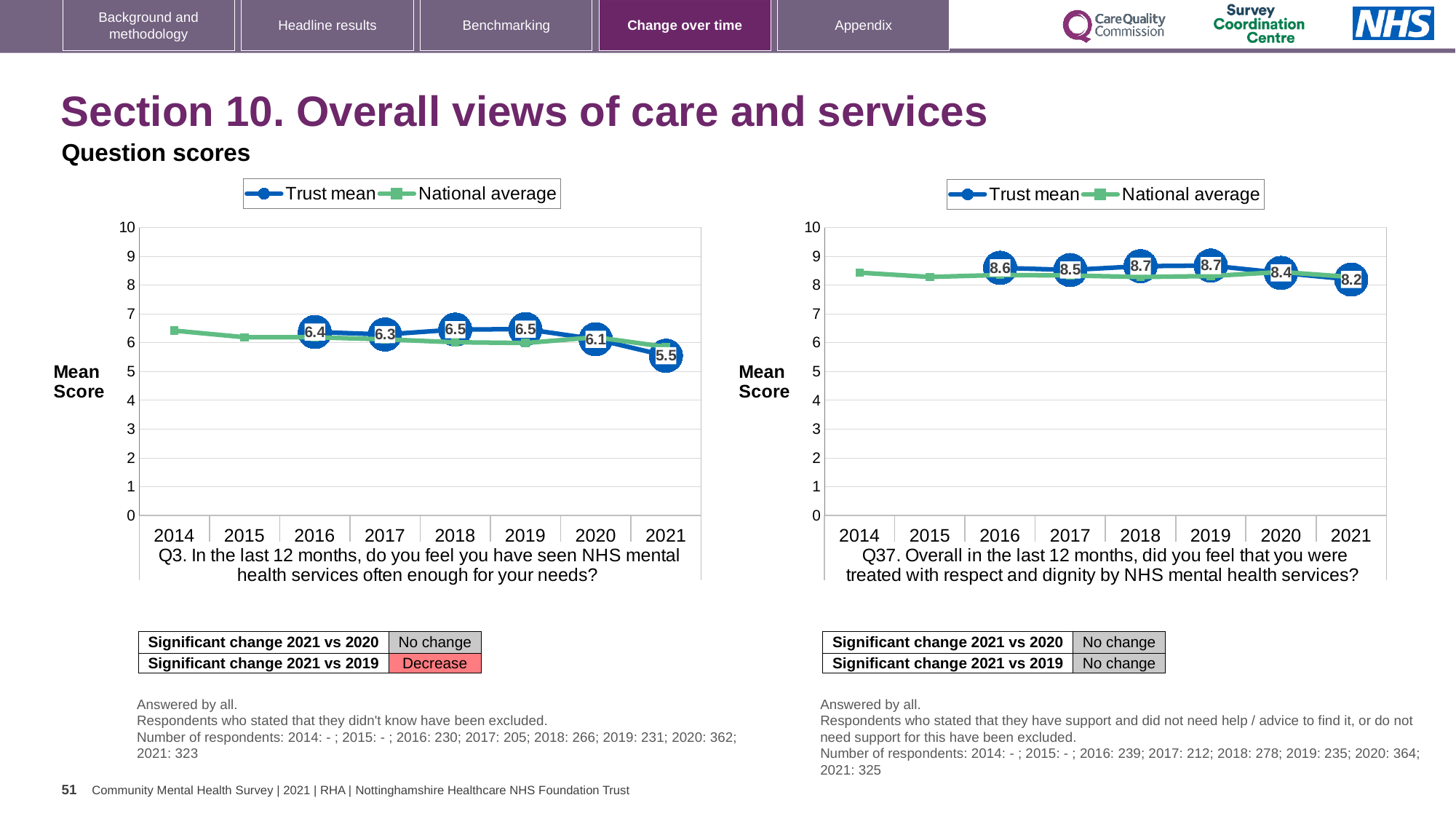
In the right chart (Q37), which year has the lowest Trust mean? 2021 In the left chart (Q3), which year has the lowest Trust mean? 2021 In the right chart (Q37), what is the difference between the Trust mean in 2019 and in 2021? 0.5 In the left chart (Q3), what is the difference between the Trust mean in 2020 and in 2021? 0.6 In the left chart (Q3), what is the Trust mean for 2021? 5.5 How many series does the legend of the right chart (Q37) list? 2 In the right chart (Q37), what is the Trust mean for 2018? 8.7 In the left chart (Q3), is the Trust mean higher in 2016 or in 2017? 2016 How many years are shown on the x axis of the left chart (Q3)? 8 In the right chart (Q37), is the National average for 2014 greater or less than 8? greater What kind of chart is the left chart (Q3)? Line chart In the right chart (Q37), does the Trust mean rise or fall from 2019 to 2021? Fall